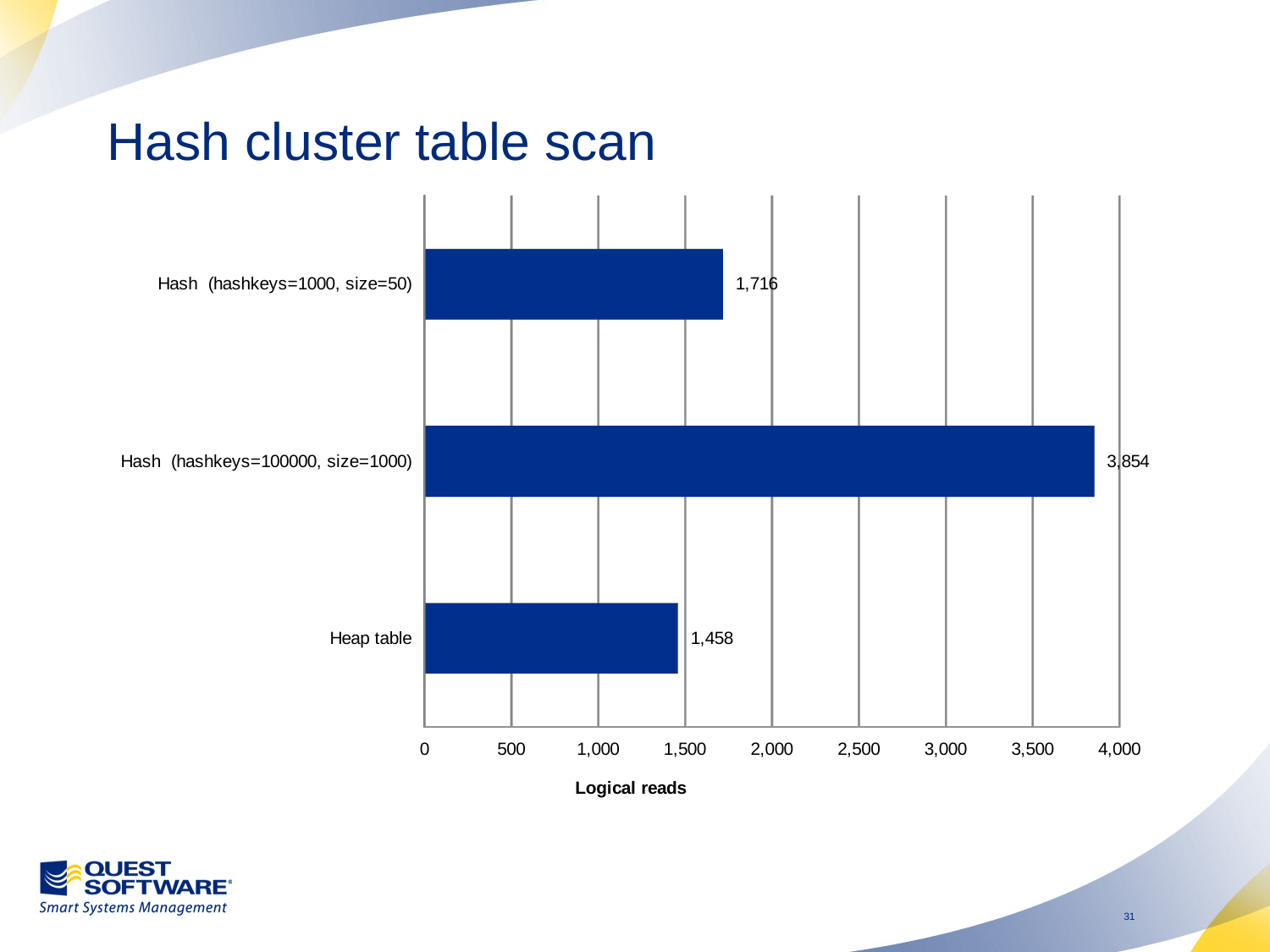
What is the number of logical reads for Hash (hashkeys=1000, size=50)? 1,716 What is the number of logical reads for the Heap table? 1,458 How many categories are shown in the chart? 3 Is the value for Hash (hashkeys=100000, size=1000) greater or less than 3,500? greater Which has more logical reads, Hash (hashkeys=1000, size=50) or the Heap table? Hash (hashkeys=1000, size=50) What is the label of the horizontal axis? Logical reads Which category has the lowest number of logical reads? Heap table What is the difference in logical reads between Hash (hashkeys=1000, size=50) and the Heap table? 258 What kind of chart is shown on the slide? Bar chart Which category has the highest number of logical reads? Hash (hashkeys=100000, size=1000) What is the number of logical reads for Hash (hashkeys=100000, size=1000)? 3,854 What is the difference in logical reads between Hash (hashkeys=100000, size=1000) and the Heap table? 2,396